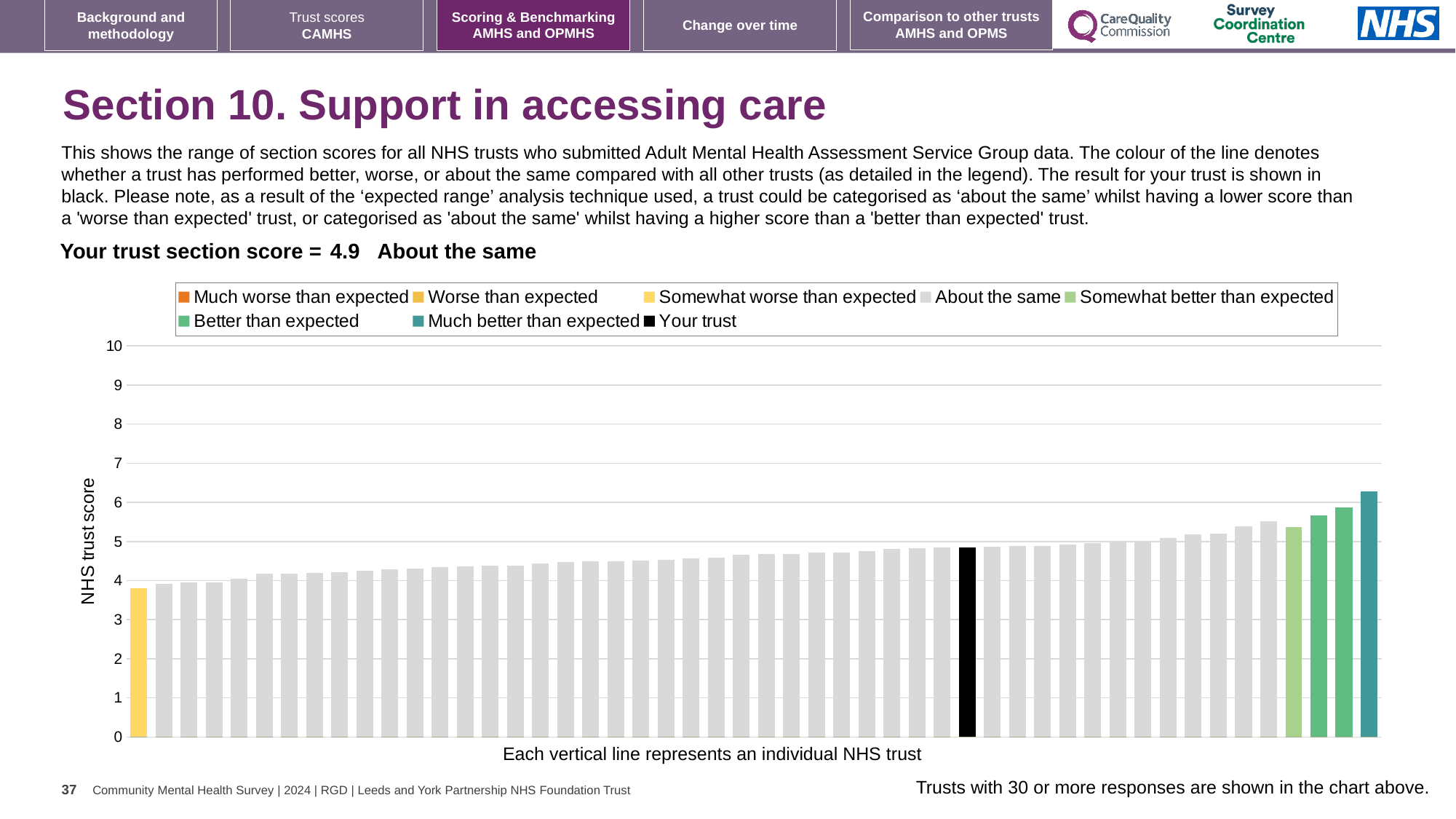
How many entries does the chart legend list? 8 Which performance category is your trust placed in for this section? About the same Is the value for the tallest bar (Much better than expected) greater or less than 5? greater Which legend category does the lowest bar in the chart belong to? Somewhat worse than expected Is the value for your trust (the black bar) greater or less than 4? greater What is the label on the vertical axis of the chart? NHS trust score What kind of chart is shown on the slide? Bar chart What colour is used for the bar representing your trust? Black What is the section score for your trust shown on the slide? 4.9 Do the bar values rise or fall from left to right along the x axis? rise Which legend category does the highest bar in the chart belong to? Much better than expected